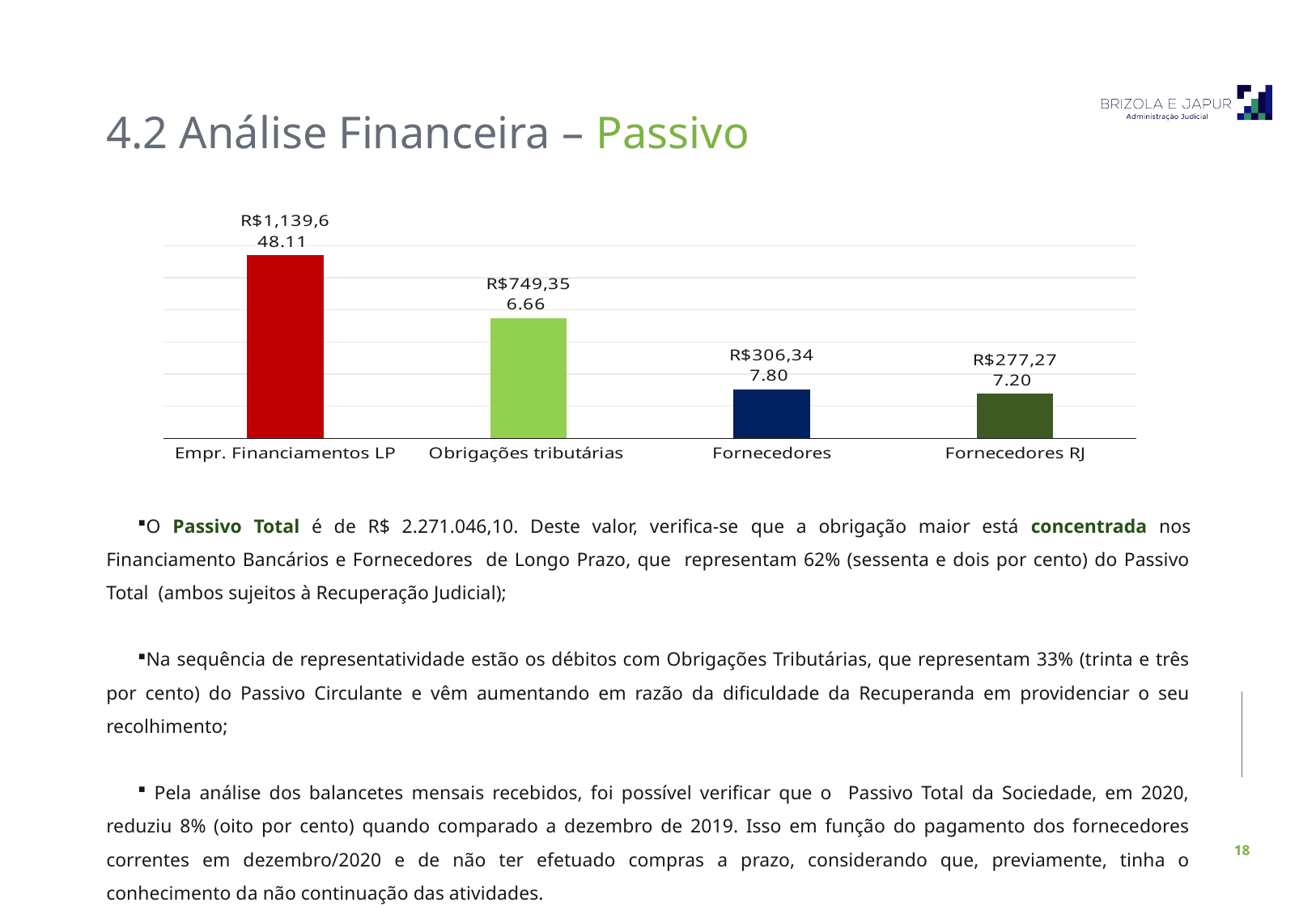
Which category has the highest value? Empr. Financiamentos LP What colour is the bar for Empr. Financiamentos LP? red What is the value for Obrigações tributárias? R$749,356.66 What is the difference between the values for Empr. Financiamentos LP and Obrigações tributárias? R$390,291.45 Which category has the lowest value? Fornecedores RJ Which is larger, the value for Fornecedores or the value for Fornecedores RJ? Fornecedores How many categories are shown in the chart? 4 What is the value for Fornecedores? R$306,347.80 What type of chart is shown on the slide? bar chart What is the value for Empr. Financiamentos LP? R$1,139,648.11 What is the difference between the values for Fornecedores and Fornecedores RJ? R$29,070.60 What is the value for Fornecedores RJ? R$277,277.20